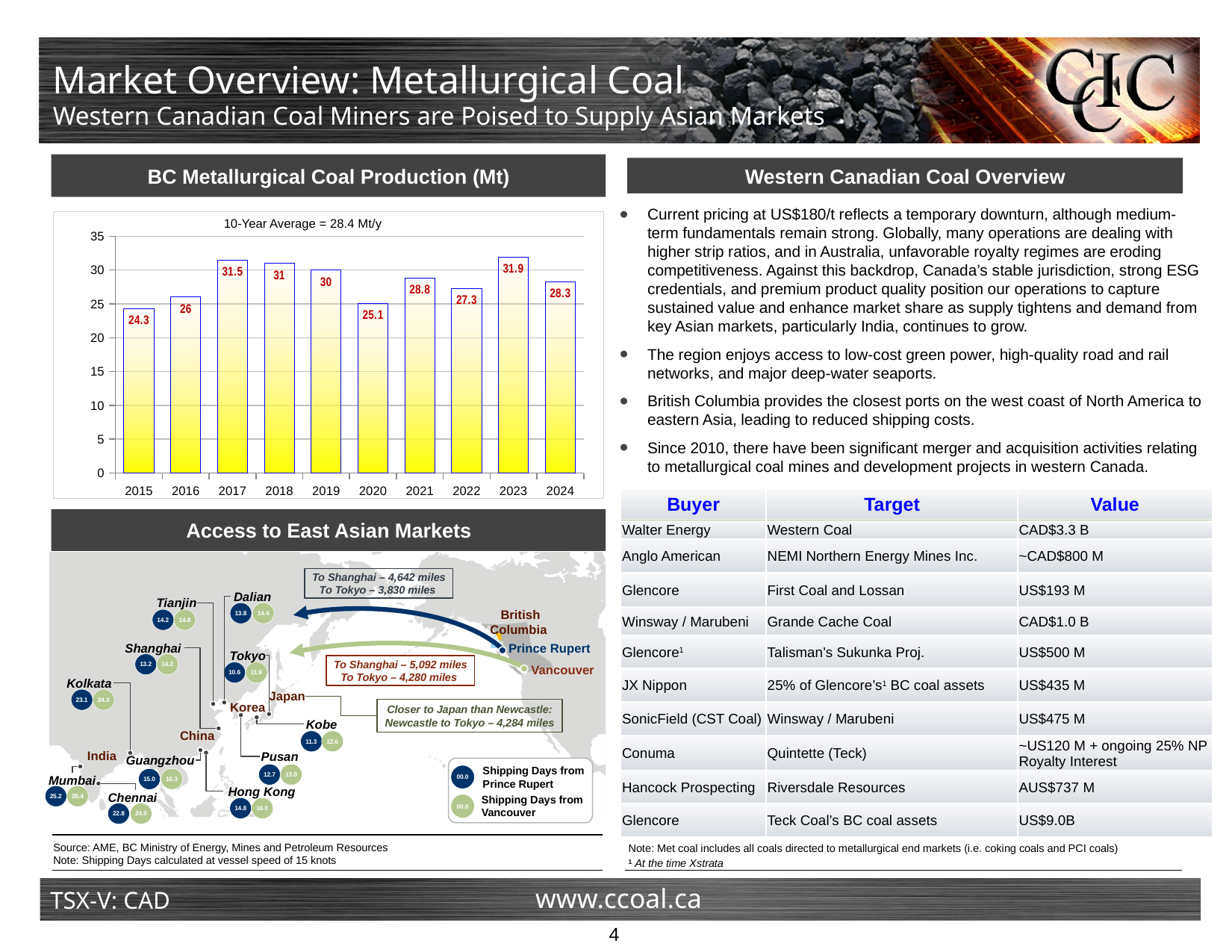
What type of chart is the BC Metallurgical Coal Production chart? bar chart In the BC Metallurgical Coal Production chart, what is the difference between production in 2017 and 2018? 0.5 In the BC Metallurgical Coal Production chart, what was production in 2024? 28.3 In the BC Metallurgical Coal Production chart, was production higher in 2021 or 2022? 2021 What 10-year average is stated on the BC Metallurgical Coal Production chart? 28.4 Mt/y In the BC Metallurgical Coal Production chart, which year had the highest production? 2023 In the BC Metallurgical Coal Production chart, which year had the lowest production? 2015 In the BC Metallurgical Coal Production chart, what is the difference between production in 2023 and 2015? 7.6 In the BC Metallurgical Coal Production chart, what was production in 2015? 24.3 In the BC Metallurgical Coal Production chart, is the value for 2019 greater or less than 25? greater How many years are shown in the BC Metallurgical Coal Production chart? 10 In the BC Metallurgical Coal Production chart, what was production in 2020? 25.1